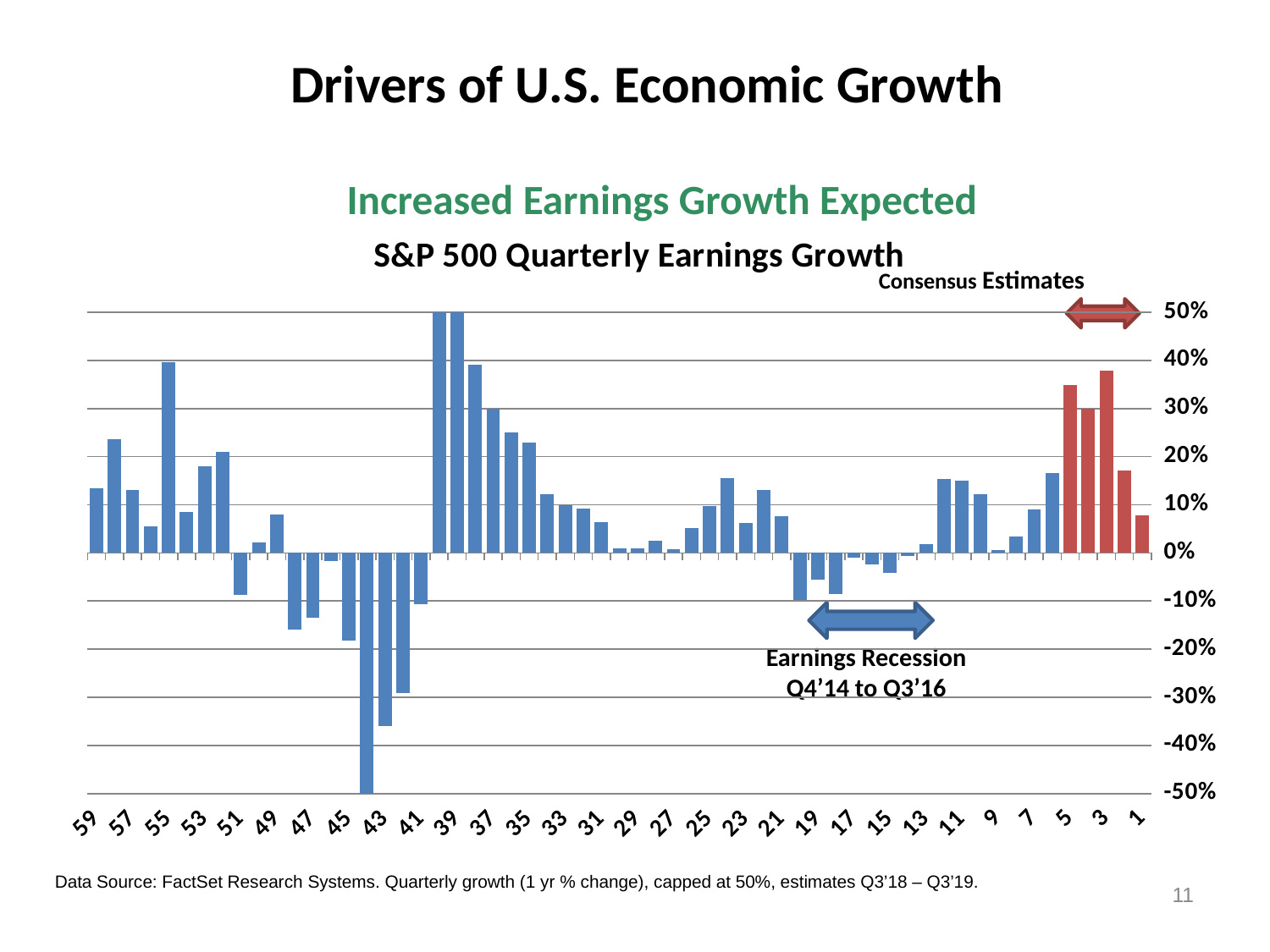
Is the value for category 55 greater or less than 30%? greater Which has the larger value, category 3 or category 1? 3 Is the value for category 45 greater or less than -10%? less How many bars are shown in red as consensus estimates? 5 Is the value for category 3 greater or less than 30%? greater What kind of chart is shown on the slide? bar chart What is the title of the chart? S&P 500 Quarterly Earnings Growth Which has the larger value, category 55 or category 57? 55